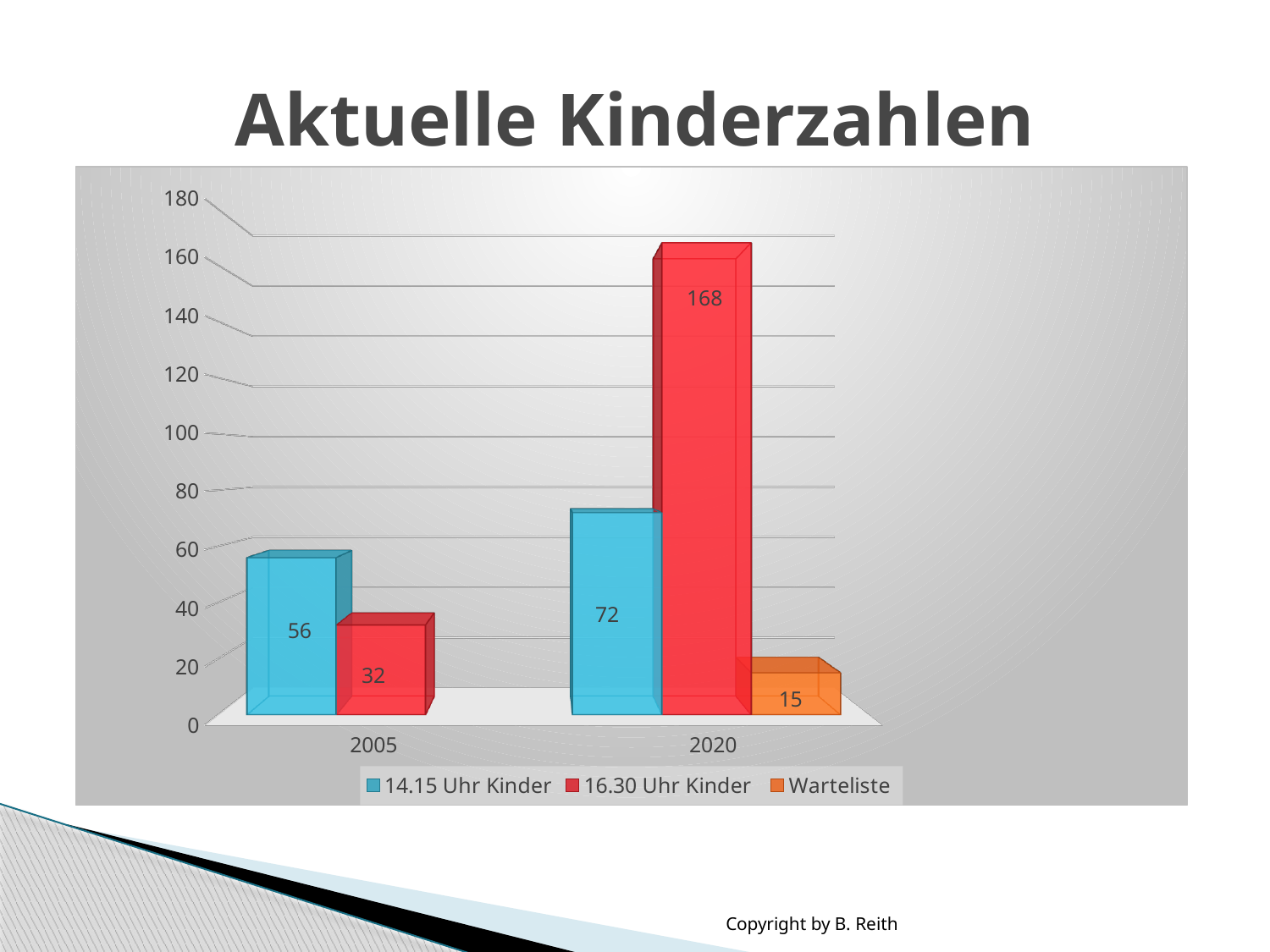
What is the value for 14.15 Uhr Kinder in 2005? 56 What is the value for 16.30 Uhr Kinder in 2005? 32 How many categories are shown on the x axis? 2 What is the value for Warteliste in 2020? 15 What is the difference between 16.30 Uhr Kinder in 2020 and in 2005? 136 Which series has the lowest value in 2020? Warteliste What is the title of the slide? Aktuelle Kinderzahlen How many series does the legend list? 3 Which series has the highest value in 2020? 16.30 Uhr Kinder What is the value for 16.30 Uhr Kinder in 2020? 168 Which is larger in 2005: 14.15 Uhr Kinder or 16.30 Uhr Kinder? 14.15 Uhr Kinder What kind of chart is shown on the slide? Bar chart